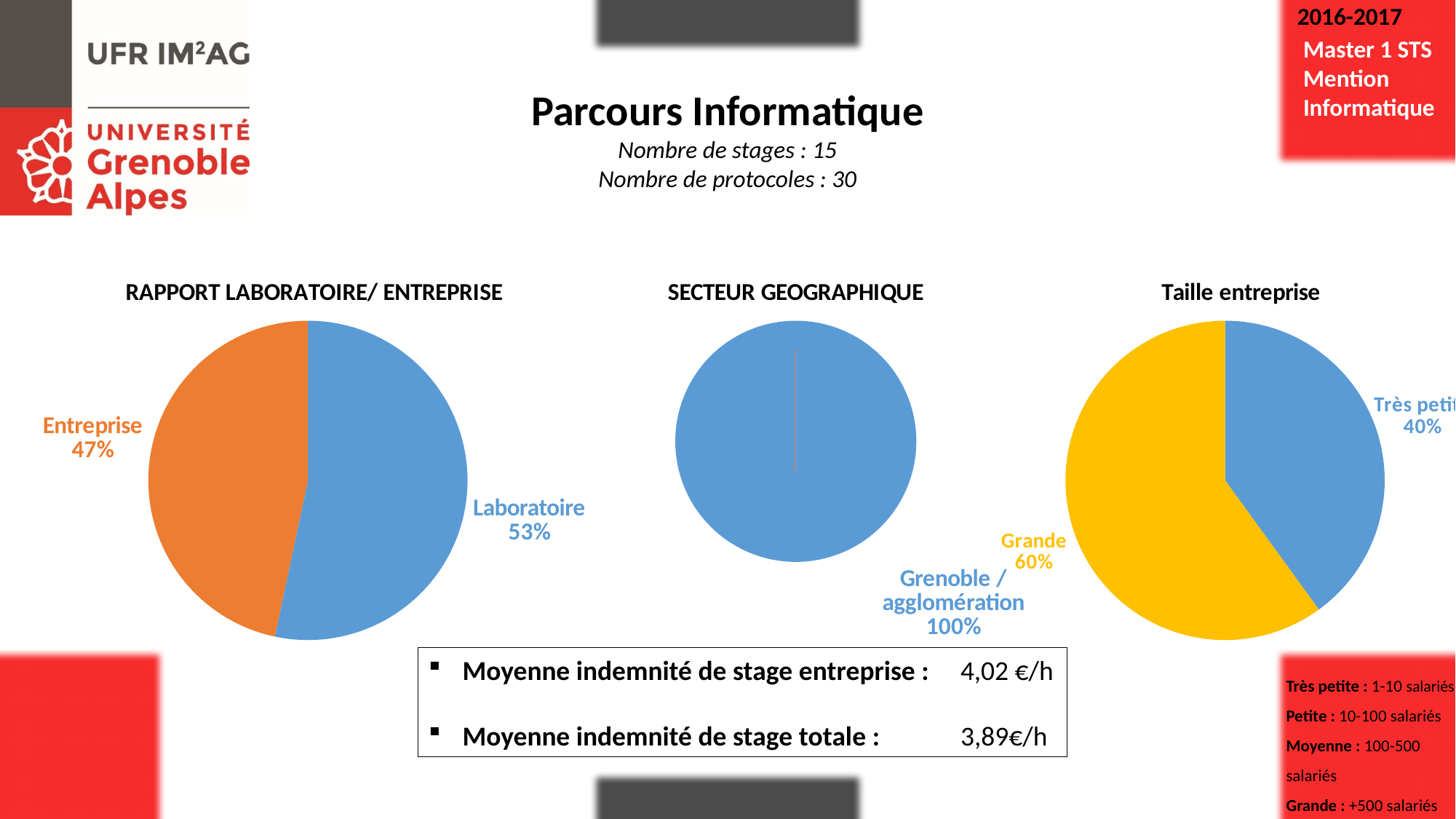
In the Taille entreprise chart, what colour is the Grande slice? Yellow In the RAPPORT LABORATOIRE/ ENTREPRISE chart, what share is Laboratoire? 53% In the Taille entreprise chart, which category has the largest share? Grande In the RAPPORT LABORATOIRE/ ENTREPRISE chart, what is the difference in percentage points between Laboratoire and Entreprise? 6 What kind of chart is the RAPPORT LABORATOIRE/ ENTREPRISE chart? Pie chart In the RAPPORT LABORATOIRE/ ENTREPRISE chart, which slice is larger, Laboratoire or Entreprise? Laboratoire In the SECTEUR GEOGRAPHIQUE chart, what share is Grenoble / agglomération? 100% In the Taille entreprise chart, what share is Très petite? 40% In the Taille entreprise chart, what share is Grande? 60% In the RAPPORT LABORATOIRE/ ENTREPRISE chart, what share is Entreprise? 47% How many slices does the SECTEUR GEOGRAPHIQUE chart have? 1 How many slices does the Taille entreprise chart have? 2